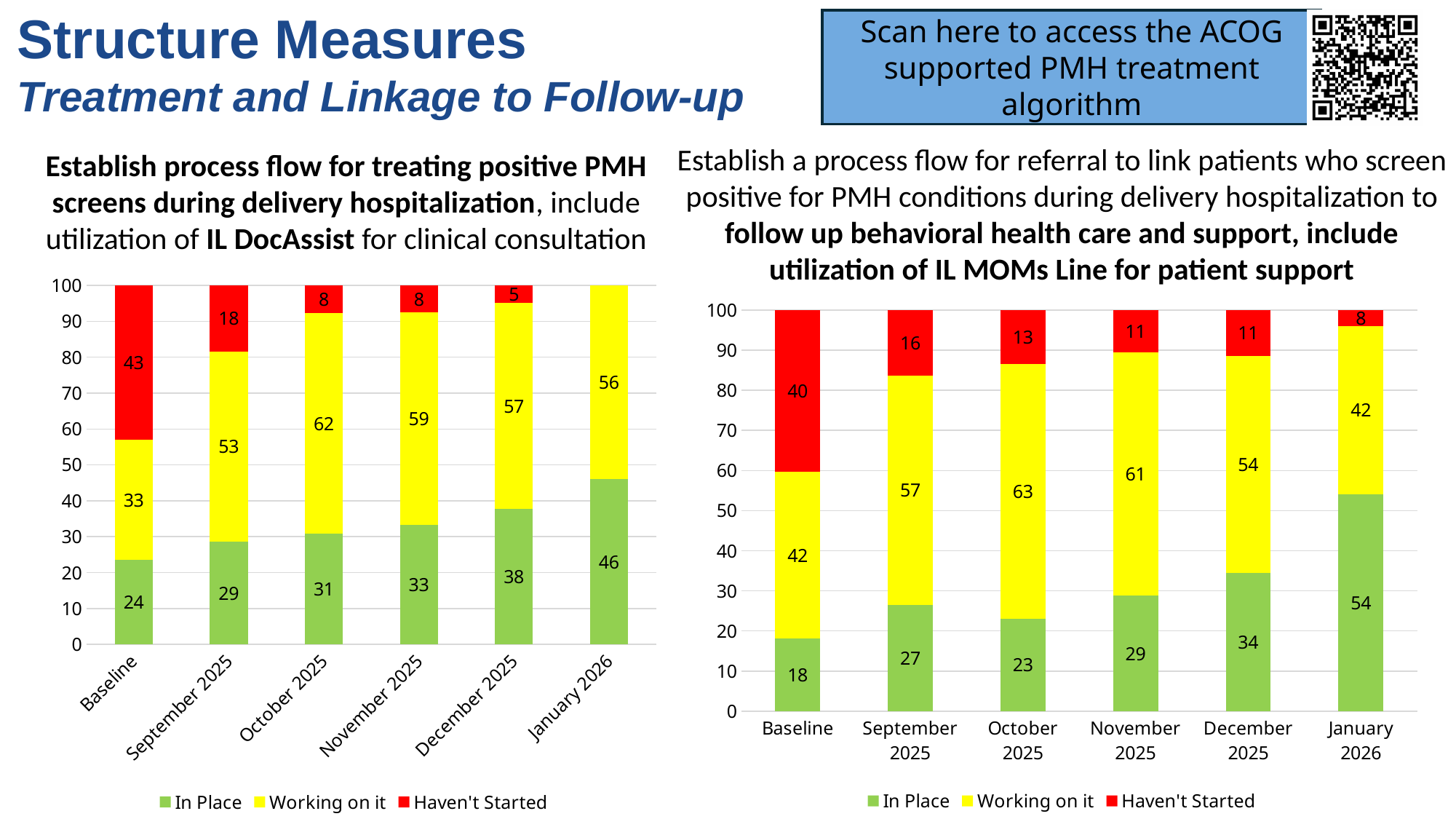
In the left chart (IL DocAssist), what is the 'Haven't Started' value for September 2025? 18 In the left chart (IL DocAssist), which category has the highest 'In Place' value? January 2026 How many categories are shown on the x axis of the right chart (IL MOMs Line)? 6 In the left chart (IL DocAssist), does the 'In Place' value rise or fall from Baseline to January 2026? Rise What kind of chart is the right chart (IL MOMs Line)? Stacked bar chart How many series does the legend of the left chart (IL DocAssist) list? 3 In the right chart (IL MOMs Line), what is the difference between the 'Haven't Started' values for Baseline and January 2026? 32 In the left chart (IL DocAssist), which is larger: the 'Working on it' value for October 2025 or for December 2025? October 2025 In the right chart (IL MOMs Line), which category has the lowest 'In Place' value? Baseline In the right chart (IL MOMs Line), what is the 'In Place' value for January 2026? 54 In the right chart (IL MOMs Line), what is the 'Working on it' value for October 2025? 63 In the left chart (IL DocAssist), what is the 'In Place' value for Baseline? 24